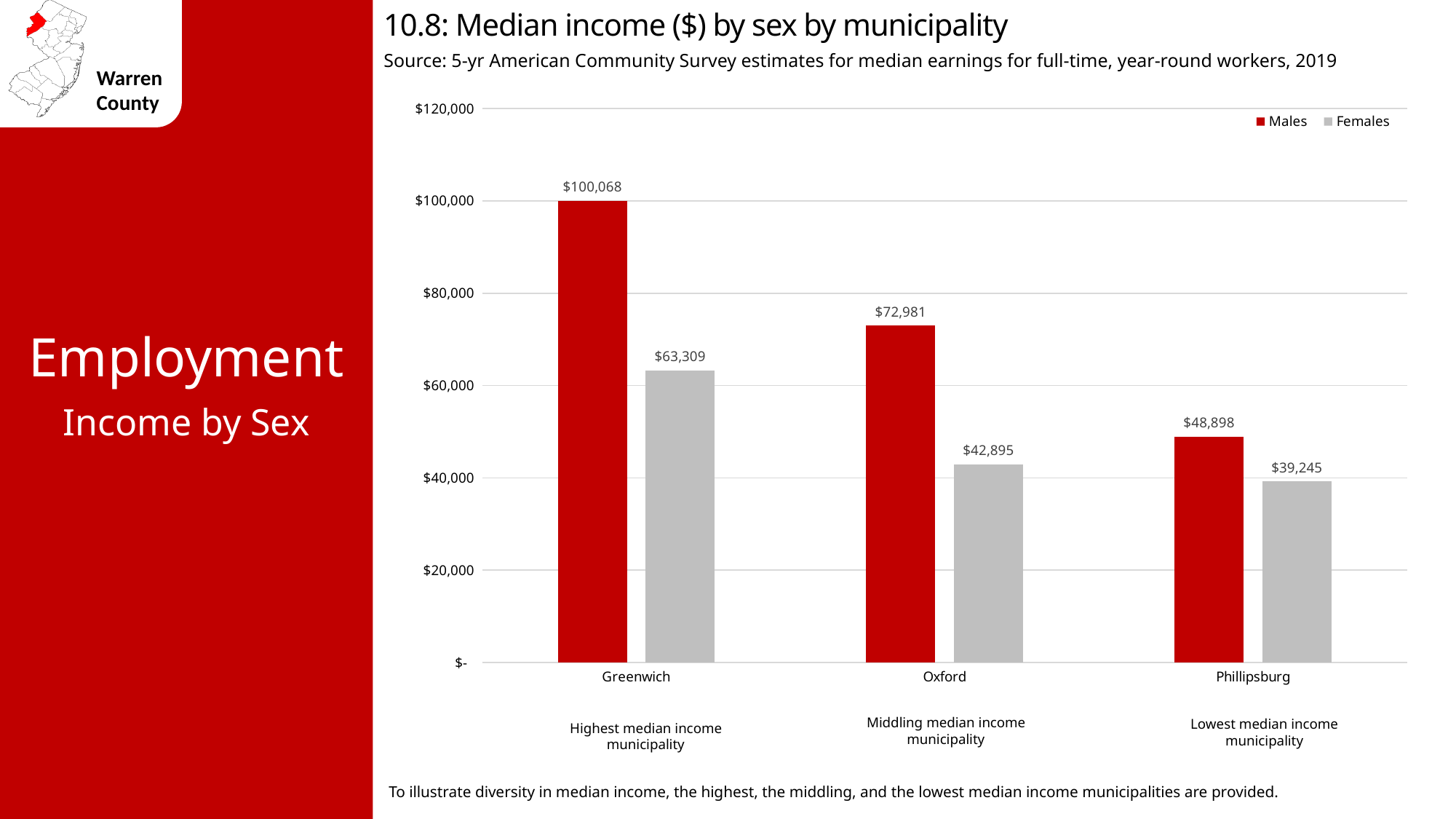
How many municipalities are shown on the chart? 3 What kind of chart is shown on the slide? Bar chart What is the difference between male and female median income in Phillipsburg? $9,653 What is the difference between male and female median income in Greenwich? $36,759 Which is larger: the female median income in Greenwich or the male median income in Phillipsburg? Female median income in Greenwich What is the median income for females in Oxford? $42,895 What is the median income for females in Phillipsburg? $39,245 Which municipality has the highest median income for males? Greenwich What is the median income for males in Greenwich? $100,068 Which colour represents Males in the chart? Red How many series does the legend list? 2 Which municipality has the lowest median income for females? Phillipsburg